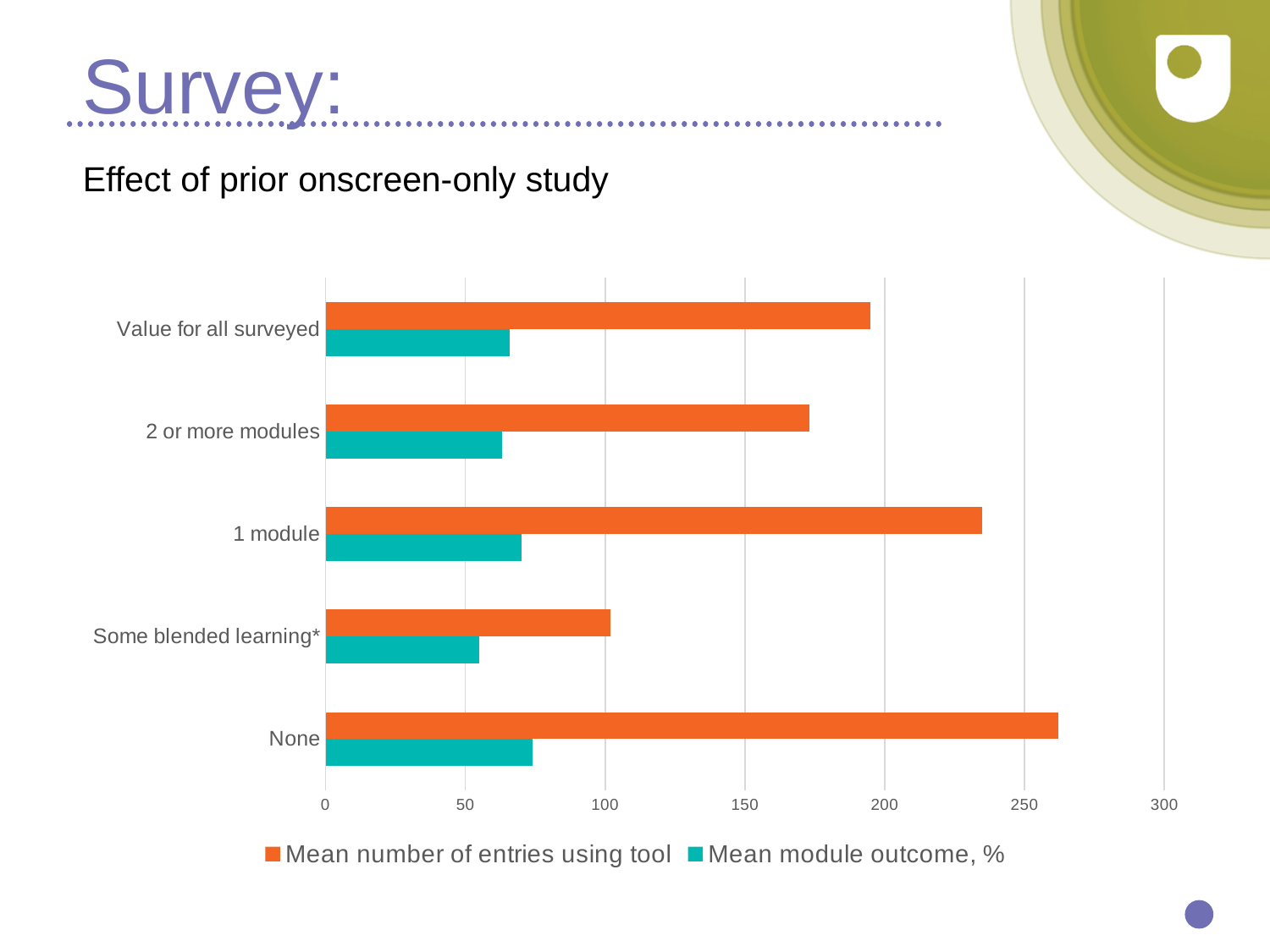
What kind of chart is shown on the slide? bar chart Which category has the lowest mean module outcome, %? Some blended learning* Is the mean number of entries using tool for 1 module greater or less than 200? greater Is the mean number of entries using tool for Some blended learning* greater or less than 150? less Is the mean module outcome, % for None greater or less than 50? greater How many categories are shown on the chart? 5 What is the subtitle shown above the chart? Effect of prior onscreen-only study Which category has the lowest mean number of entries using tool? Some blended learning* How many series does the legend list? 2 Which category has the highest mean number of entries using tool? None Which has the larger mean number of entries using tool: 1 module or 2 or more modules? 1 module